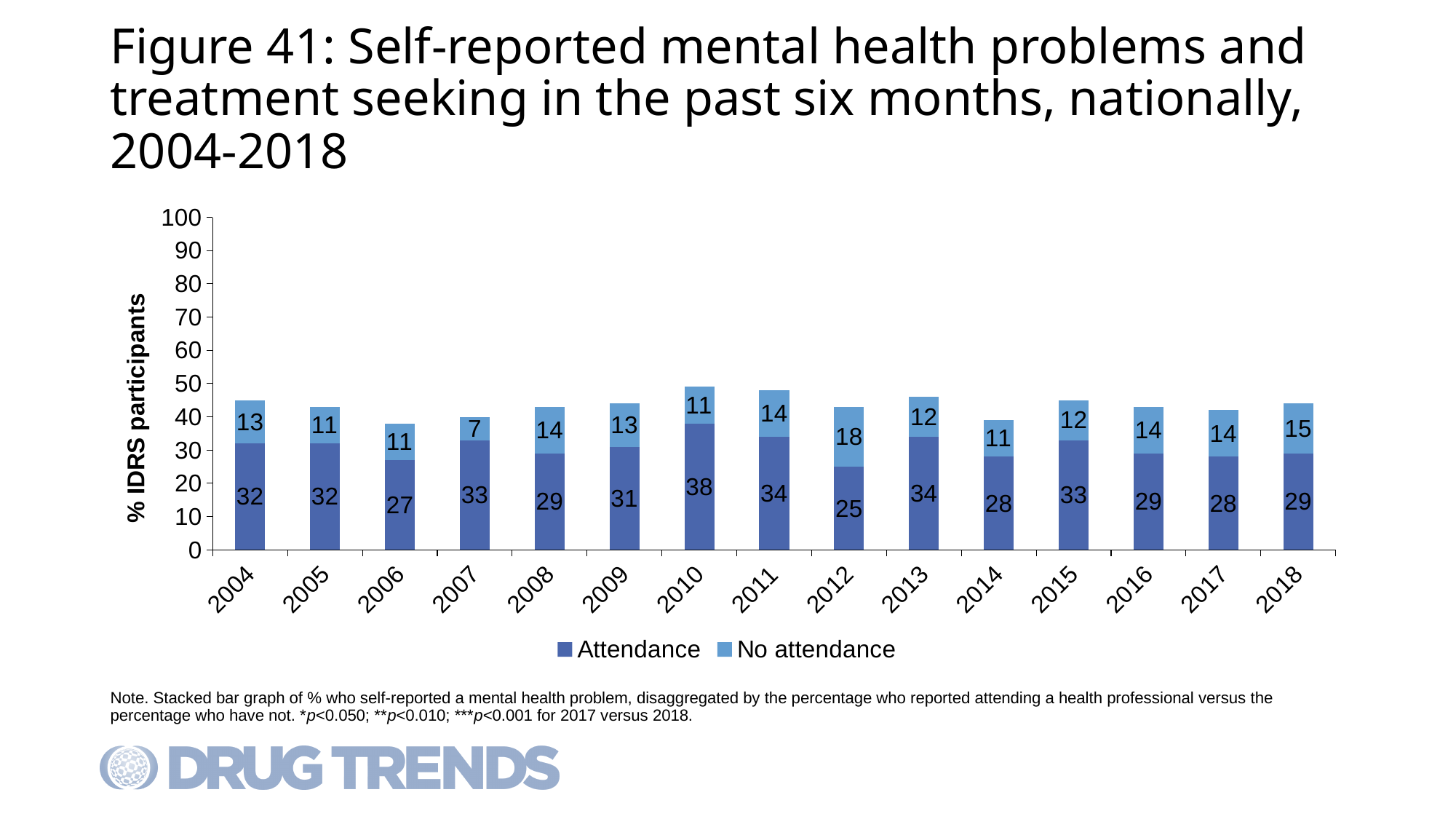
Which is larger, the No attendance value for 2012 or for 2014? 2012 What is the difference between the Attendance values for 2010 and 2012? 13 Which year has the highest Attendance value? 2010 What is the Attendance value for 2010? 38 Which year has the lowest Attendance value? 2012 Which year has the lowest No attendance value? 2007 What is the No attendance value for 2012? 18 How many years are shown on the x axis? 15 What is the Attendance value for 2018? 29 What kind of chart is shown on the slide? Stacked bar chart How many series does the legend list? 2 What is the total of the stacked bar for 2010? 49